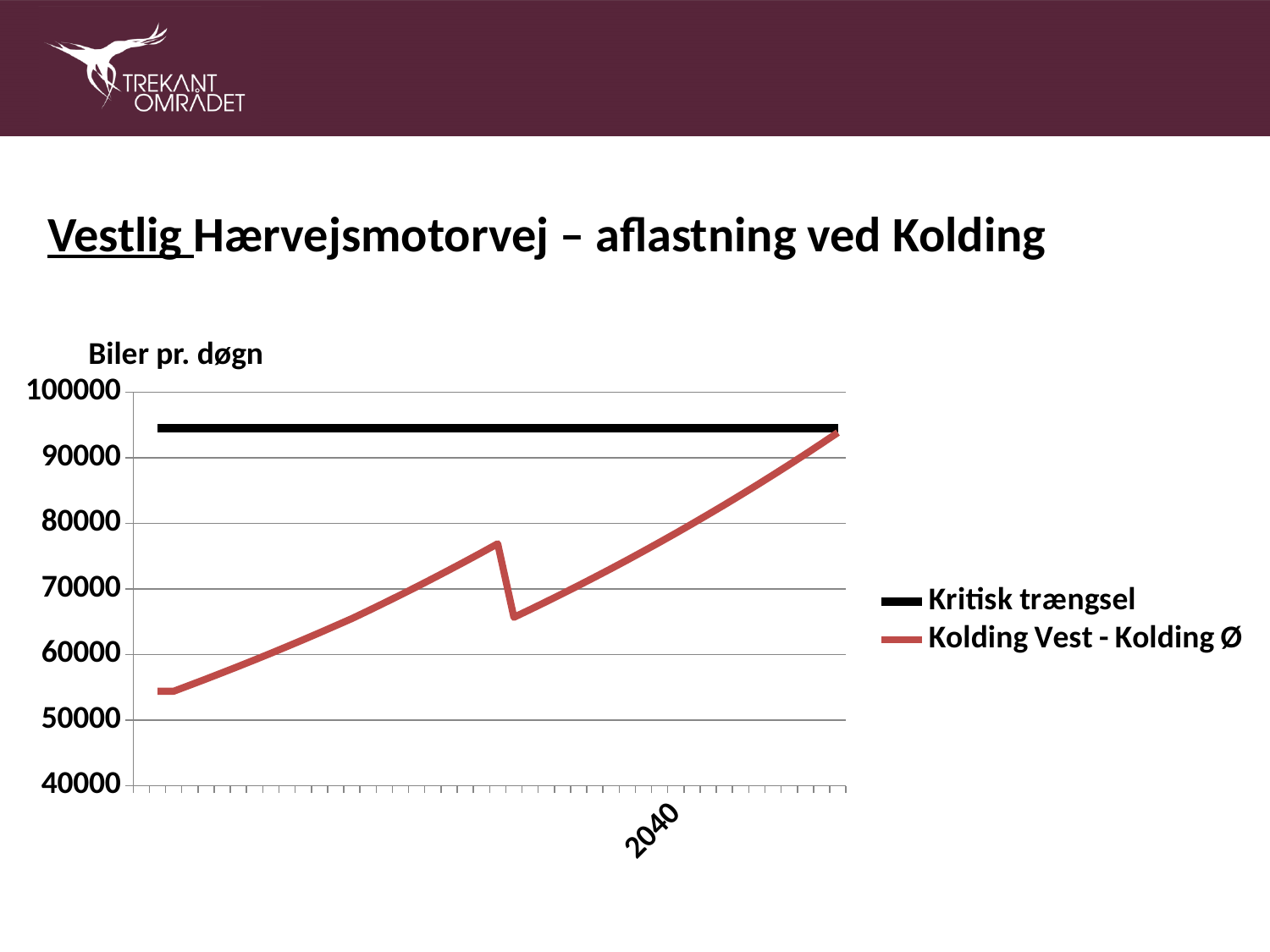
Is the lowest point of the Kolding Vest - Kolding Ø line right after its sudden drop greater or less than 60000? greater What kind of chart is shown on the slide? line chart How many series does the legend list? 2 What is the title of the slide's chart section? Vestlig Hærvejsmotorvej – aflastning ved Kolding Is the starting value of the Kolding Vest - Kolding Ø line greater or less than 50000? greater Does the Kolding Vest - Kolding Ø line overall rise or fall along the x axis? rise What label is shown above the vertical axis? Biler pr. døgn Is the starting value of the Kolding Vest - Kolding Ø line greater or less than 60000? less At the left end of the chart, which series has the higher value: Kritisk trængsel or Kolding Vest - Kolding Ø? Kritisk trængsel Which year label is shown on the x axis? 2040